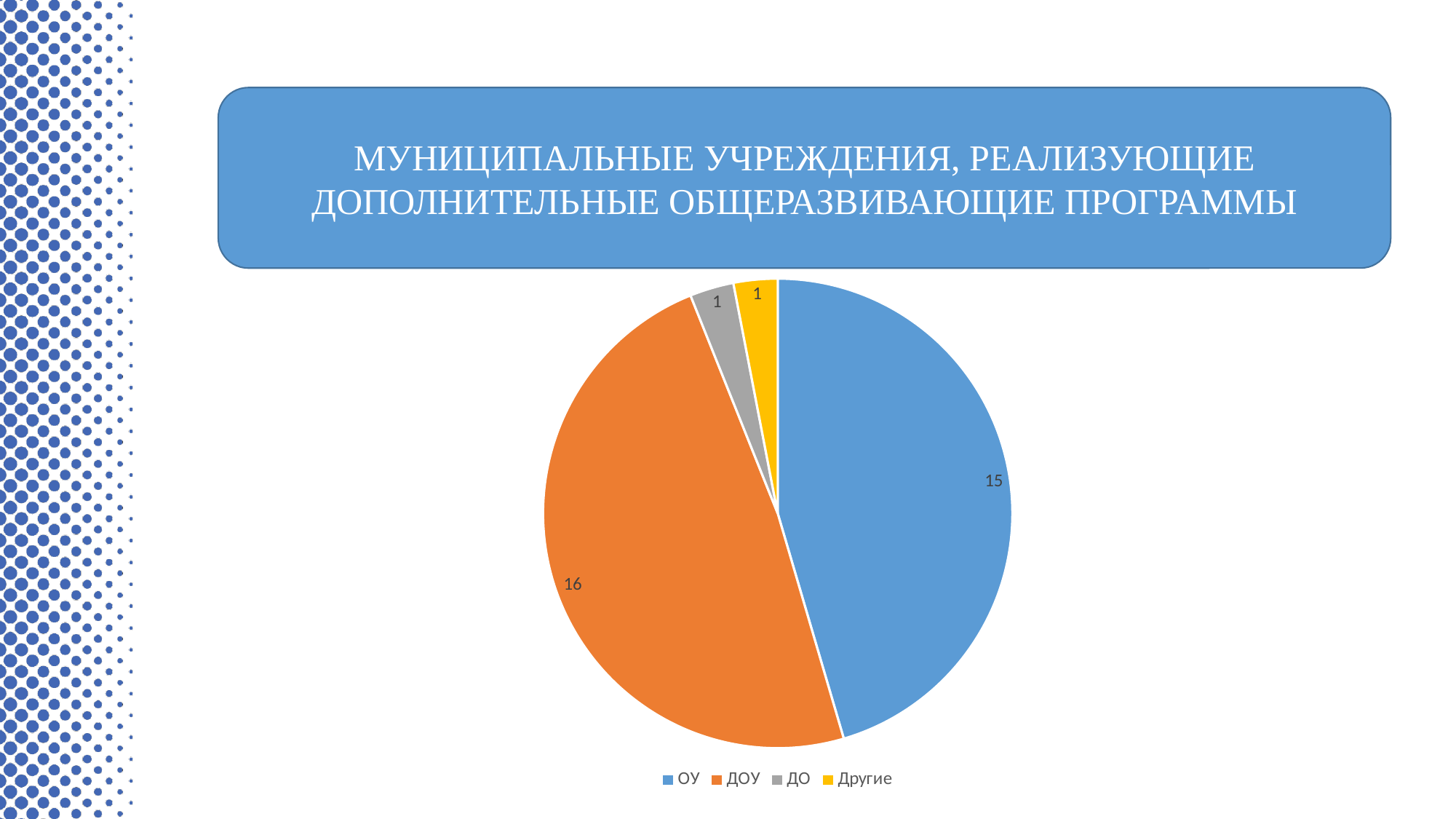
What is the value for ОУ in the pie chart? 15 What is the value for ДО in the pie chart? 1 What colour is the slice for Другие in the pie chart? Yellow What is the total of all the slices in the pie chart? 33 What is the difference between the values for ДОУ and ОУ? 1 Which is larger, the value for ОУ or the value for ДОУ? ДОУ What is the value for Другие in the pie chart? 1 What is the value for ДОУ in the pie chart? 16 Which category has the largest slice in the pie chart? ДОУ What type of chart is shown on the slide? Pie chart How many categories does the pie chart have? 4 What is the title shown above the pie chart? МУНИЦИПАЛЬНЫЕ УЧРЕЖДЕНИЯ, РЕАЛИЗУЮЩИЕ ДОПОЛНИТЕЛЬНЫЕ ОБЩЕРАЗВИВАЮЩИЕ ПРОГРАММЫ